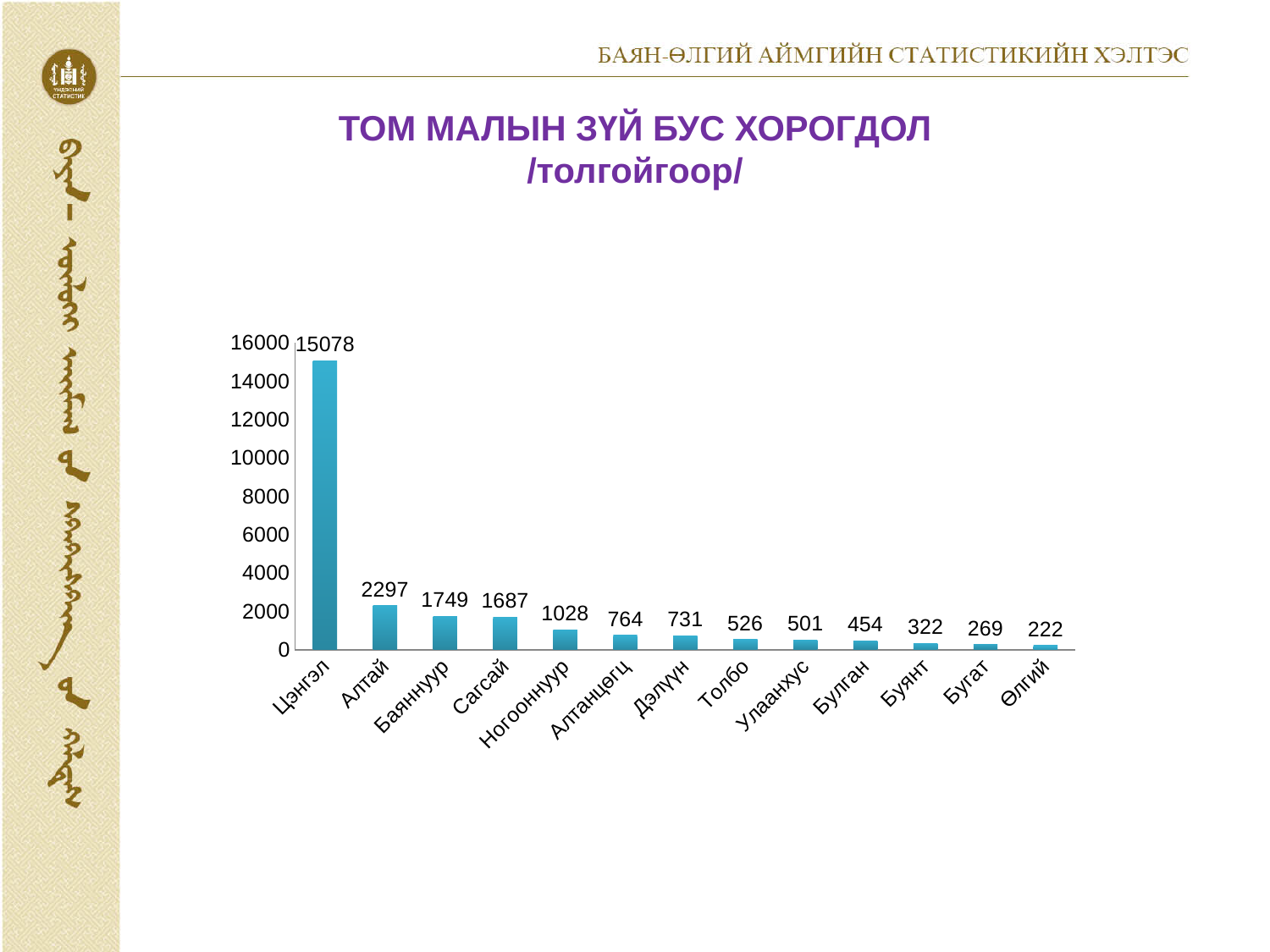
What is the title of the chart? ТОМ МАЛЫН ЗҮЙ БУС ХОРОГДОЛ /толгойгоор/ Is the value for Алтай greater or less than 2000? greater Which is larger, the value for Сагсай or the value for Алтанцөгц? Сагсай What is the value for Цэнгэл? 15078 Which category has the lowest value? Өлгий Which category has the highest value? Цэнгэл What kind of chart is shown on the slide? bar chart How many categories are shown on the x axis? 13 What is the value for Ногооннуур? 1028 What is the value for Улаанхус? 501 What is the difference between the values for Алтай and Баяннуур? 548 What is the difference between the values for Бугат and Өлгий? 47